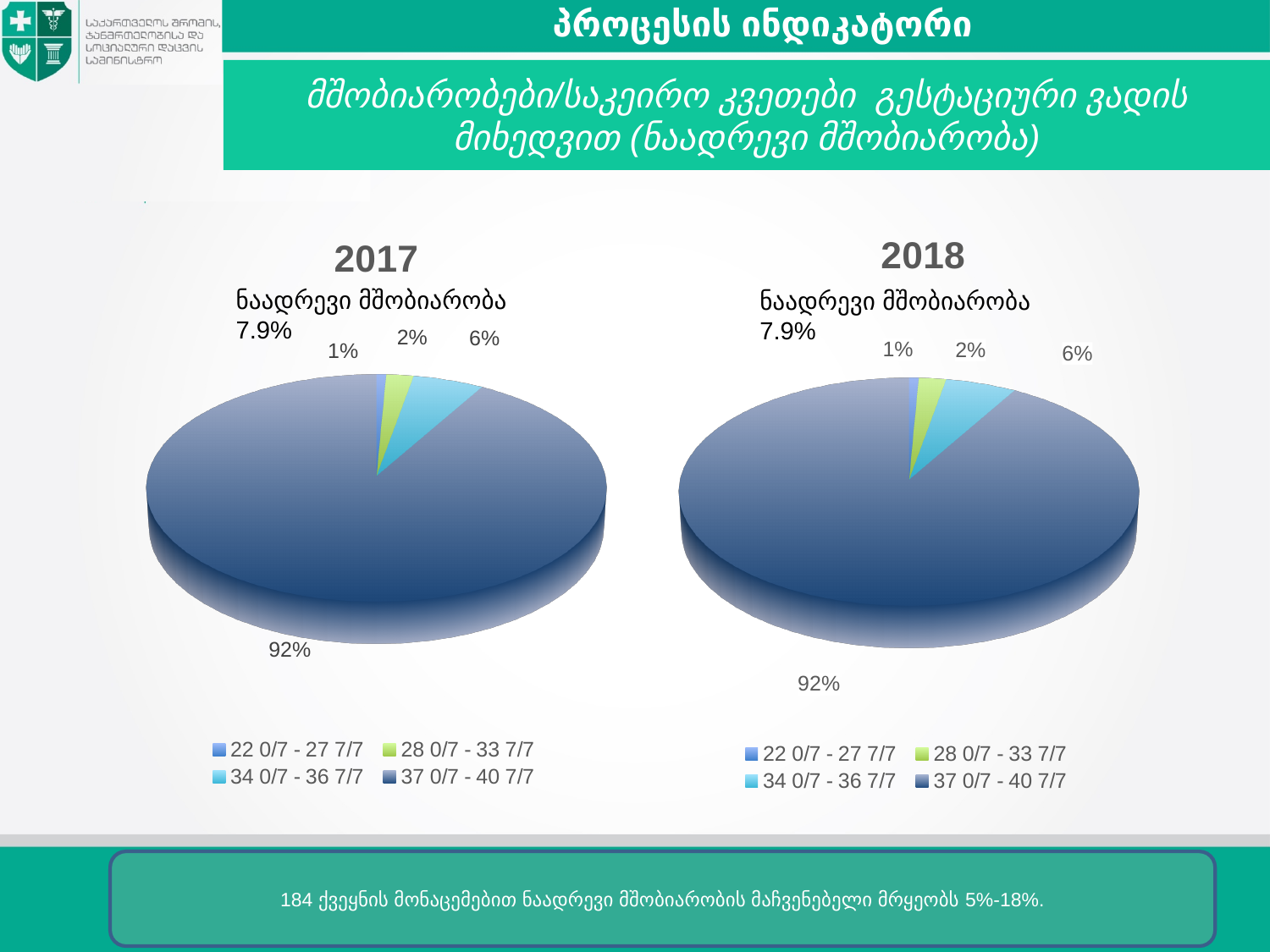
How many entries does the legend of the 2018 chart list? 4 In the 2017 pie chart, which category has the largest slice? 37 0/7 - 40 7/7 In the 2018 pie chart, which category has the smallest slice? 22 0/7 - 27 7/7 In the 2017 pie chart, which is larger: the 34 0/7 - 36 7/7 slice or the 28 0/7 - 33 7/7 slice? 34 0/7 - 36 7/7 In the 2017 pie chart, what share is labelled for the 28 0/7 - 33 7/7 category? 2% How many slices does the 2017 pie chart have? 4 In the 2018 pie chart, what share is labelled for the 34 0/7 - 36 7/7 category? 6% In the 2017 pie chart, what share is labelled for the 37 0/7 - 40 7/7 category? 92% What type of chart is used for the 2018 data? Pie chart In the 2018 pie chart, what share is labelled for the 22 0/7 - 27 7/7 category? 1% In the 2018 pie chart, what is the difference between the 34 0/7 - 36 7/7 share and the 28 0/7 - 33 7/7 share? 4% What year is shown as the title of the left chart? 2017